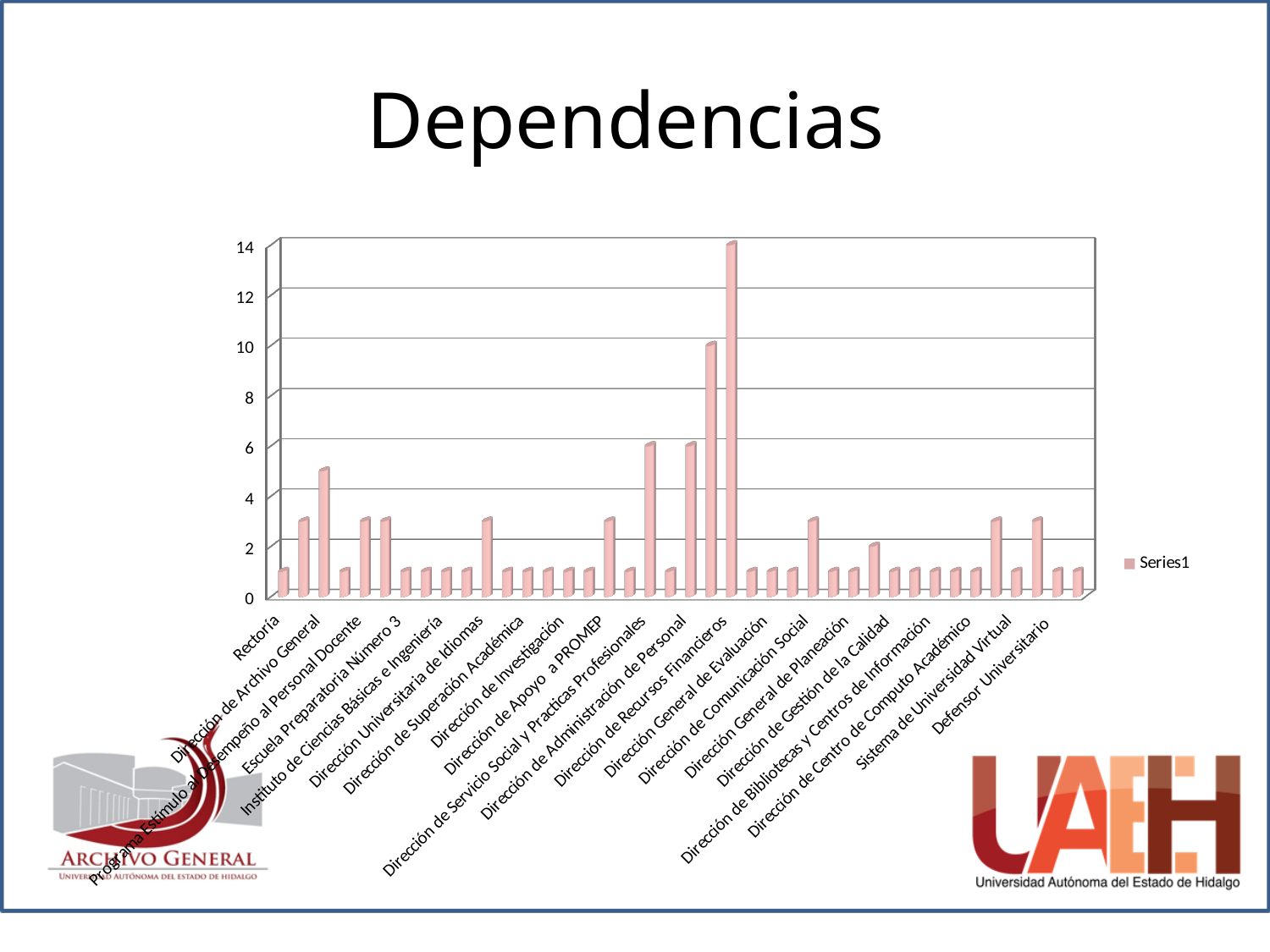
What is the interval between consecutive tick marks on the vertical axis? 2 Is the value for Defensor Universitario greater or less than 2? less What is the highest value shown on the vertical axis? 14 What is the title of the chart? Dependencias How many category labels are printed along the horizontal axis? 20 What is the name of the series shown in the legend? Series1 Is the highest value in the chart greater or less than 12? greater Is the value for Rectoría greater or less than 2? less What is the value of the tallest bar in the chart? 14 What kind of chart is shown on the slide? bar chart How many series does the legend list? 1